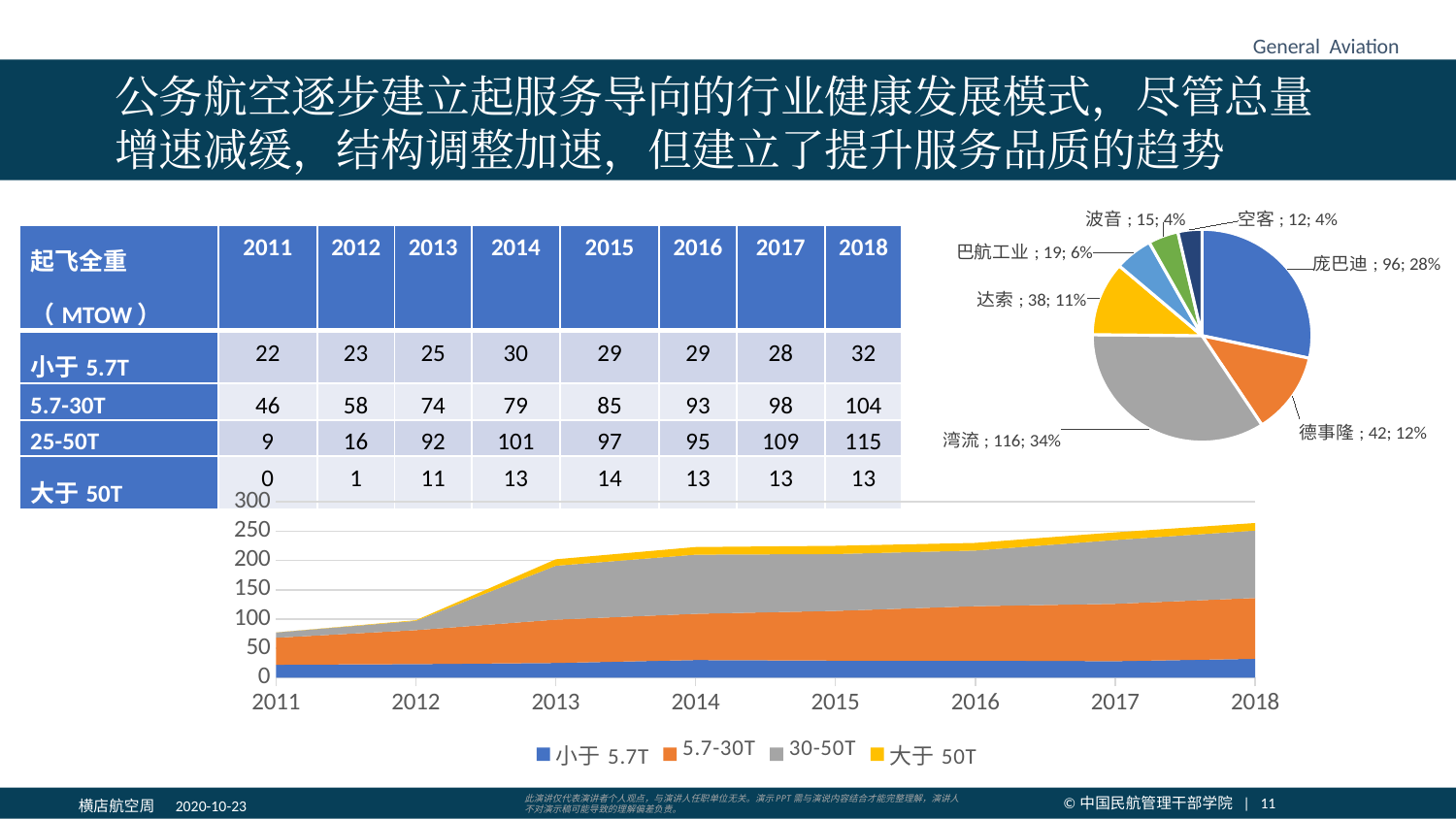
How many slices does the pie chart have? 7 On the pie chart, what share does 德事隆 have? 12% On the pie chart, which is larger, the value for 达索 or the value for 巴航工业? 达索 On the pie chart, what is the value shown for 庞巴迪? 96; 28% On the bottom area chart, is the total stacked value for 2018 greater or less than 250? greater On the pie chart, what is the difference between the values for 湾流 and 庞巴迪? 20 How many series does the legend of the bottom area chart list? 4 On the pie chart, which category has the smallest slice? 空客 On the pie chart, what is the value shown for 湾流? 116; 34% What kind of chart is the chart at the bottom of the slide with years 2011 to 2018 on the x axis? Stacked area chart On the pie chart, which category has the largest slice? 湾流 On the bottom area chart, does the total stacked value rise or fall from 2011 to 2018? Rise